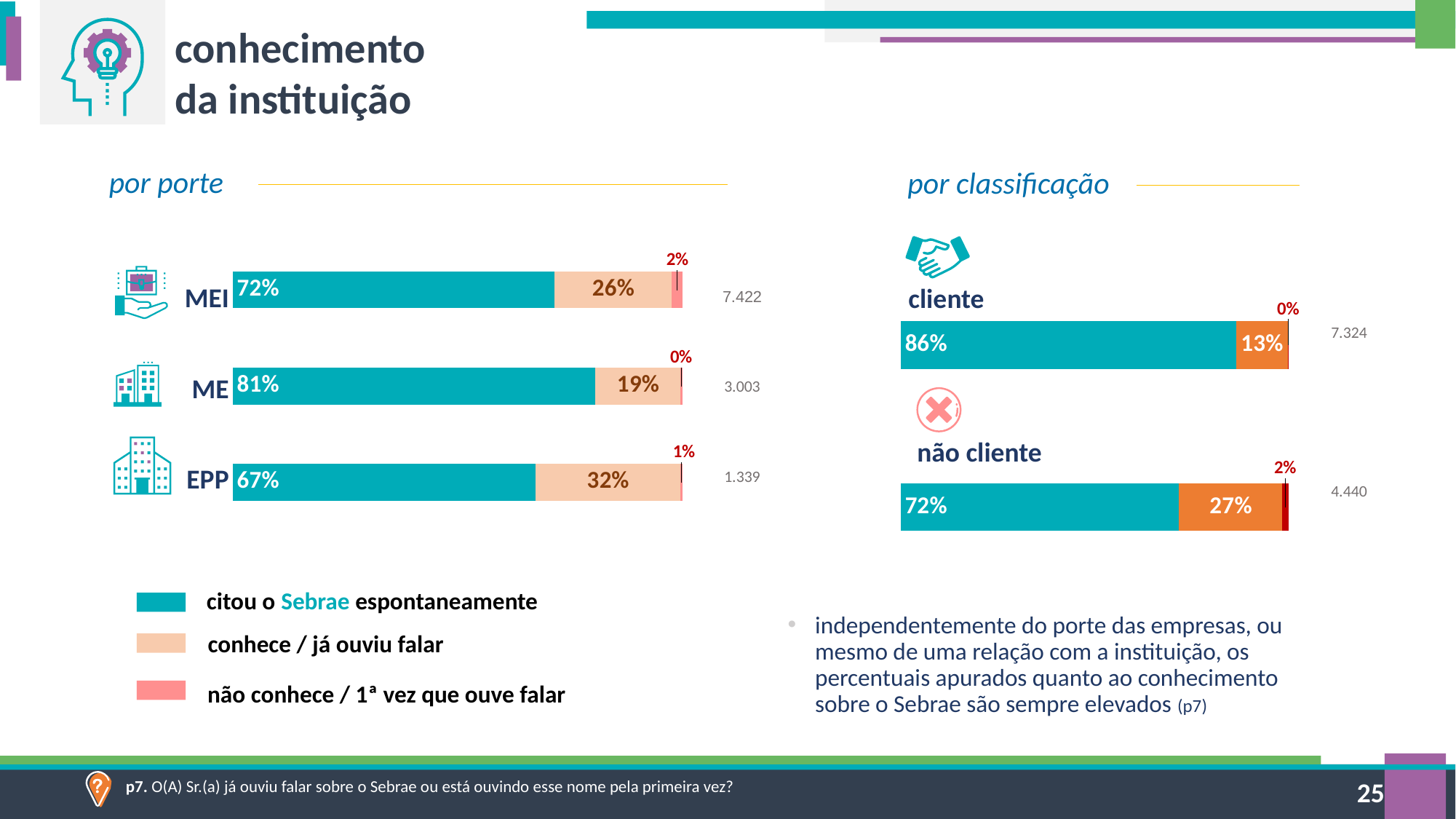
In the 'por porte' chart, what is the sample size (n) shown next to the MEI bar? 7.422 In the 'por porte' chart, how many categories (portes) are shown? 3 What type of chart is used in the 'por porte' section? Stacked bar chart In the 'por porte' chart, which category has the lowest 'citou o Sebrae espontaneamente' percentage? EPP In the 'por classificação' chart, what percentage of 'cliente' respondents cited Sebrae spontaneously? 86% How many series does the legend list? 3 In the 'por porte' chart, what is the 'conhece / já ouviu falar' percentage for EPP? 32% In the 'por classificação' chart, which group has the larger 'conhece / já ouviu falar' percentage, cliente or não cliente? não cliente In the 'por porte' chart, what is the difference between the 'citou o Sebrae espontaneamente' percentages for ME and EPP? 14% In the 'por porte' chart, which category has the highest 'citou o Sebrae espontaneamente' percentage? ME In the 'por porte' chart, what percentage of MEI respondents cited Sebrae spontaneously ('citou o Sebrae espontaneamente')? 72% In the 'por classificação' chart, what is the 'não conhece / 1ª vez que ouve falar' percentage for 'não cliente'? 2%